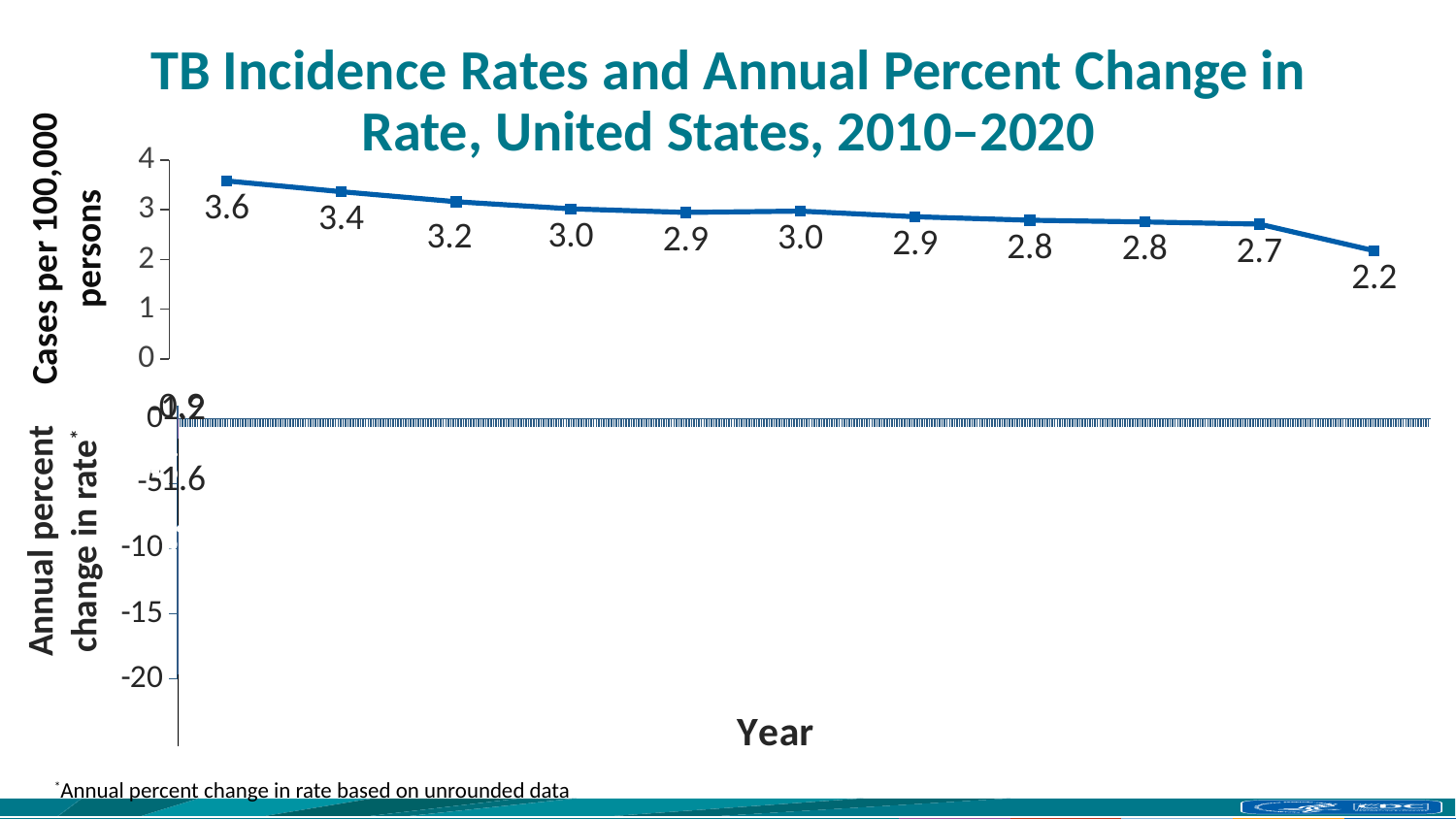
What is the title of the slide's chart? TB Incidence Rates and Annual Percent Change in Rate, United States, 2010–2020 In the top chart (Cases per 100,000 persons), what is the difference between the first data point (3.6) and the last data point (2.2)? 1.4 In the top chart (Cases per 100,000 persons), what is the value of the first data point on the left? 3.6 What type of chart is the top chart (Cases per 100,000 persons)? Line chart What is the y-axis label of the top chart? Cases per 100,000 persons In the top chart (Cases per 100,000 persons), what is the value of the second data point from the left? 3.4 In the top chart (Cases per 100,000 persons), how many data points are plotted on the line? 11 In the top chart (Cases per 100,000 persons), what is the lowest value plotted? 2.2 In the top chart (Cases per 100,000 persons), do the values generally rise or fall from left to right? Fall In the top chart (Cases per 100,000 persons), what is the value of the last data point on the right? 2.2 In the top chart (Cases per 100,000 persons), what is the highest value plotted? 3.6 In the top chart (Cases per 100,000 persons), is the first data point larger or smaller than the last data point? Larger